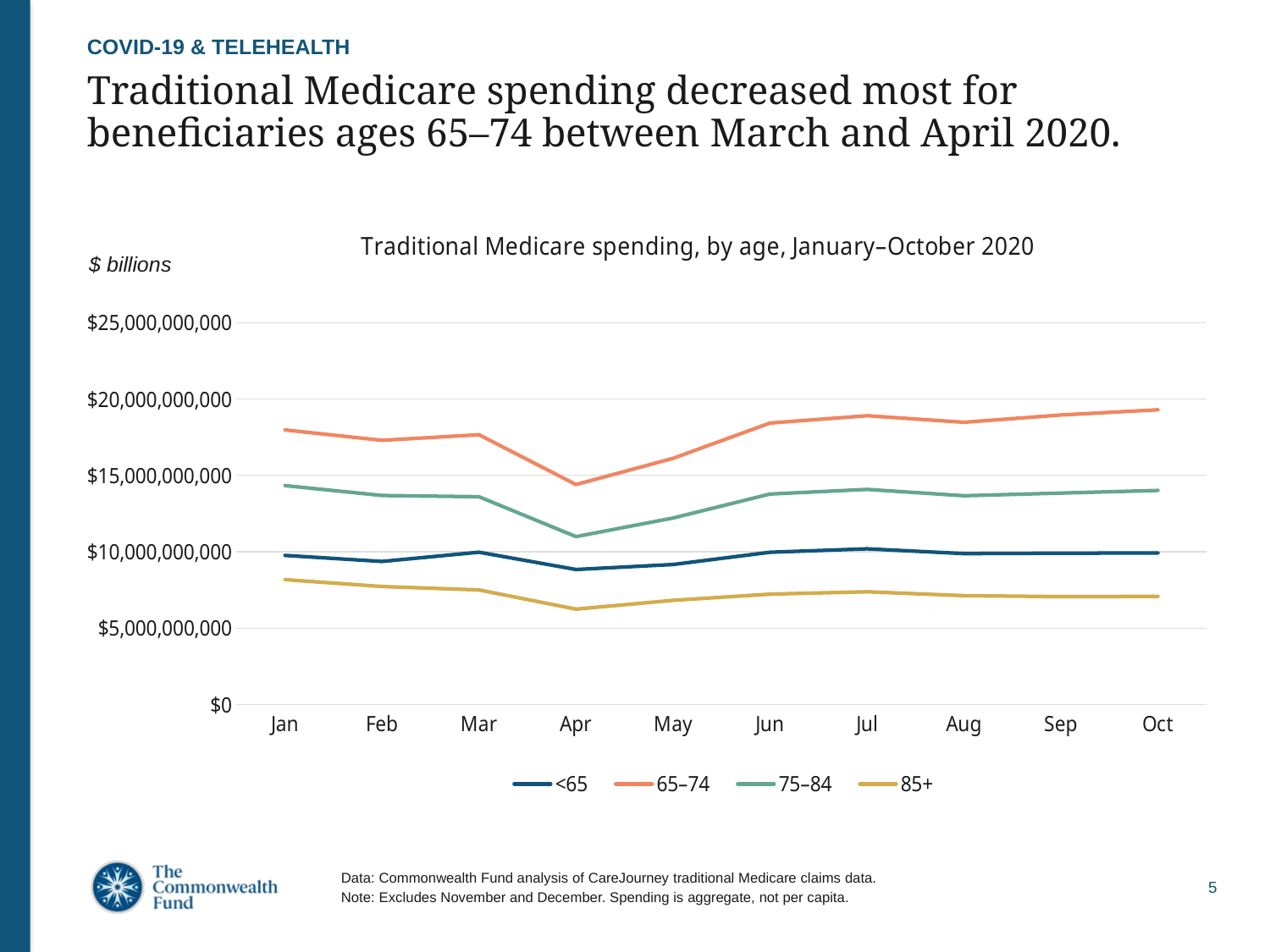
How many series does the legend list? 4 Which age group has the highest spending across the chart? 65–74 In which month is spending for the 85+ group lowest? Apr Is the value for the 85+ group in Apr greater or less than $10,000,000,000? less Is the value for the 65–74 group in Oct greater or less than $20,000,000,000? less What kind of chart is shown on the slide? line chart Does spending for the 65–74 group rise or fall between Mar and Apr? fall How many months are plotted along the x axis? 10 Which age group has the lowest spending across the chart? 85+ What is the title of the chart? Traditional Medicare spending, by age, January–October 2020 Is the value for the 65–74 group in Jan greater or less than $15,000,000,000? greater In which month is spending for the 65–74 group lowest? Apr